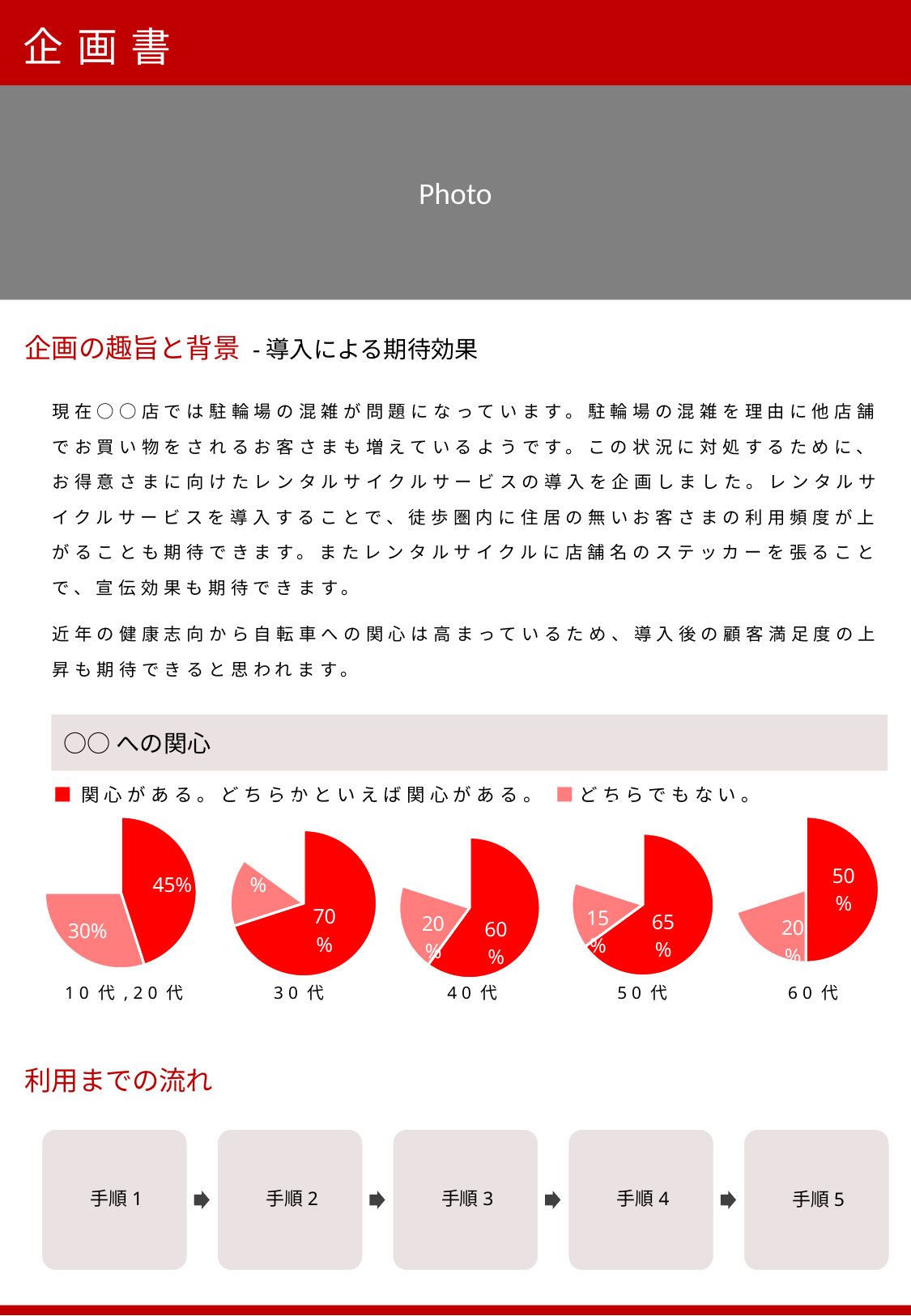
In the 60代 pie chart, what is the value for どちらでもない。? 20% Across the five pie charts under ○○への関心, which age group has the highest value for 関心がある。どちらかといえば関心がある。? 30代 How many series does the legend above the ○○への関心 pie charts list? 2 In the 40代 pie chart, what is the value for どちらでもない。? 20% In the 10代,20代 pie chart, what is the value for 関心がある。どちらかといえば関心がある。? 45% In the 10代,20代 pie chart, what is the value for どちらでもない。? 30% In the 60代 pie chart, what is the value for 関心がある。どちらかといえば関心がある。? 50% In the 40代 pie chart, what is the value for 関心がある。どちらかといえば関心がある。? 60% In the 50代 pie chart, what is the value for どちらでもない。? 15% In the 50代 pie chart, what is the value for 関心がある。どちらかといえば関心がある。? 65% In the 50代 pie chart, what is the difference between the 関心がある。どちらかといえば関心がある。 value and the どちらでもない。 value? 50% In the 30代 pie chart, what is the value for 関心がある。どちらかといえば関心がある。? 70%